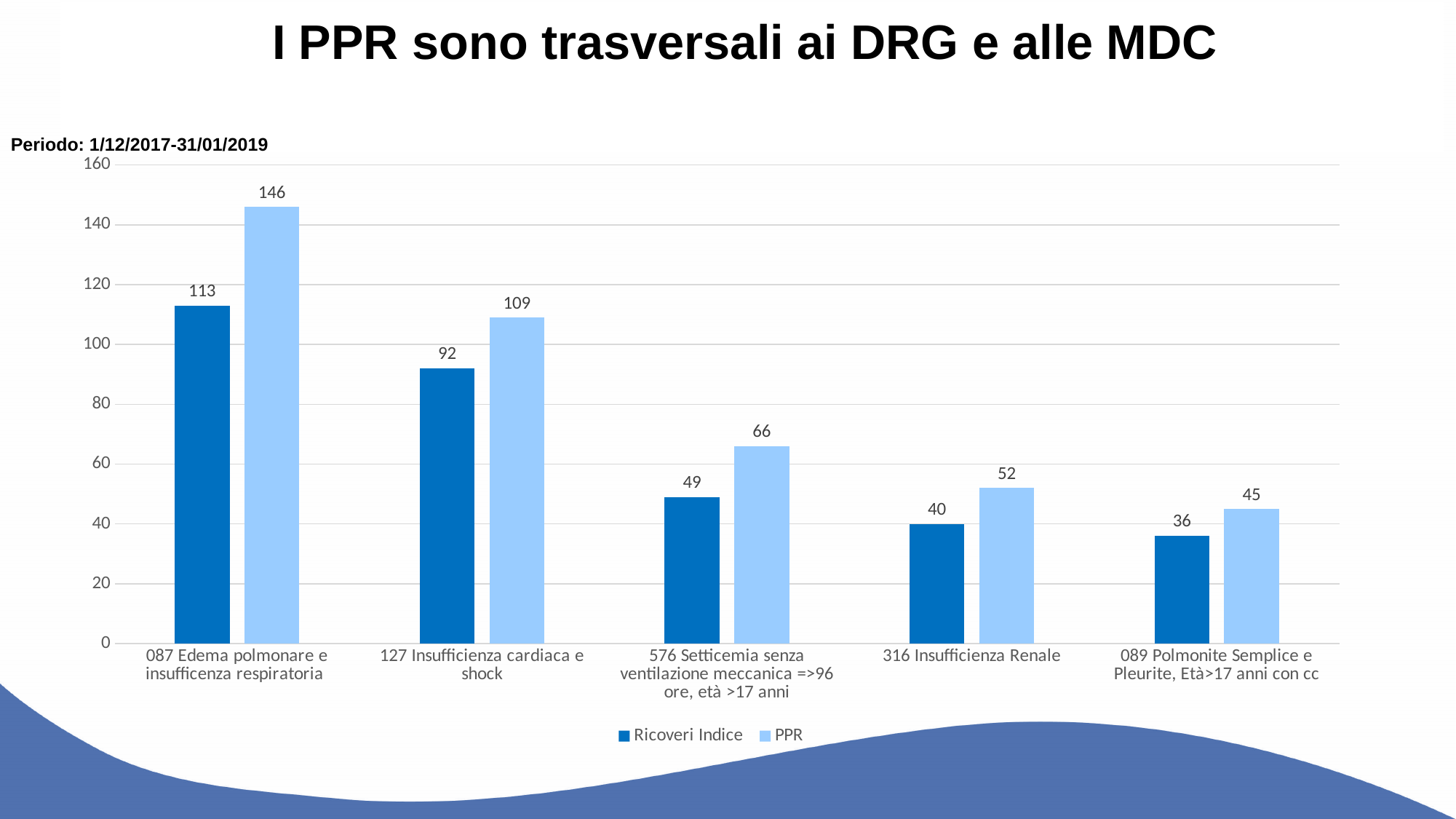
Which category has the lowest Ricoveri Indice value? 089 Polmonite Semplice e Pleurite, Età>17 anni con cc What is the PPR value for 316 Insufficienza Renale? 52 What period is stated above the chart? 1/12/2017-31/01/2019 How many series does the legend list? 2 What kind of chart is shown on the slide? Bar chart What is the difference between the PPR values for 576 Setticemia senza ventilazione meccanica =>96 ore, età >17 anni and 316 Insufficienza Renale? 14 Which category has the highest PPR value? 087 Edema polmonare e insufficenza respiratoria What is the PPR value for 127 Insufficienza cardiaca e shock? 109 How many categories are shown on the x axis? 5 What is the Ricoveri Indice value for 087 Edema polmonare e insufficenza respiratoria? 113 Which is larger: the Ricoveri Indice value for 127 Insufficienza cardiaca e shock or the PPR value for 576 Setticemia senza ventilazione meccanica =>96 ore, età >17 anni? Ricoveri Indice for 127 Insufficienza cardiaca e shock What is the difference between the PPR and Ricoveri Indice values for 087 Edema polmonare e insufficenza respiratoria? 33